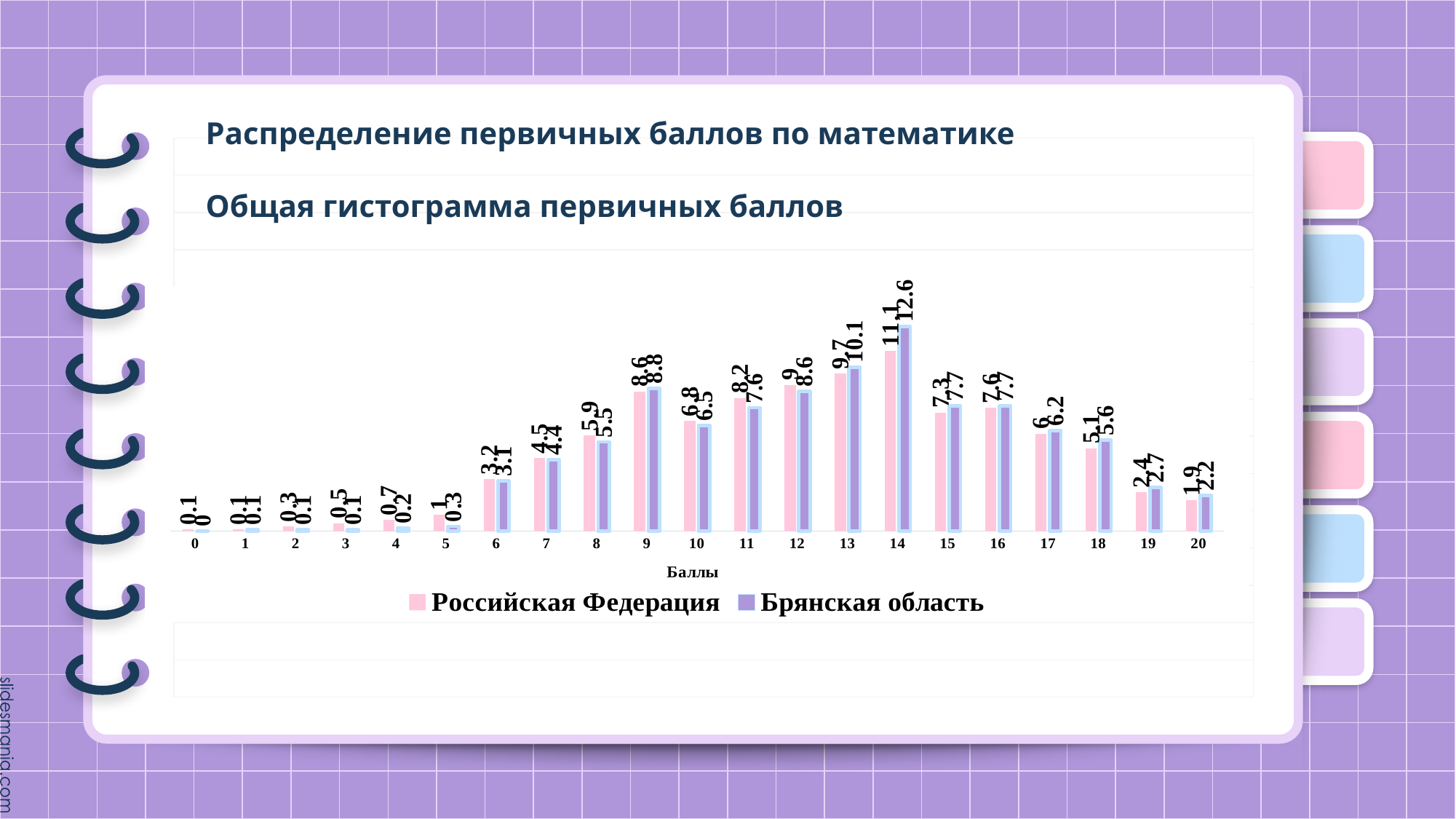
What is the value for Брянская область at 20 баллов? 2.2 At which score does Брянская область reach its highest value? 14 How many score categories (баллы) are shown on the x axis? 21 At which score does Российская Федерация reach its highest value? 14 What is the difference between Брянская область and Российская Федерация at 14 баллов? 1.5 What is the value for Брянская область at 14 баллов? 12.6 At 13 баллов, which series has the larger value? Брянская область How many series does the legend list? 2 Do the values for Российская Федерация rise or fall from 14 to 20 баллов? fall Which two series are listed in the legend? Российская Федерация and Брянская область What kind of chart is shown on the slide? bar chart What is the value for Российская Федерация at 14 баллов? 11.1